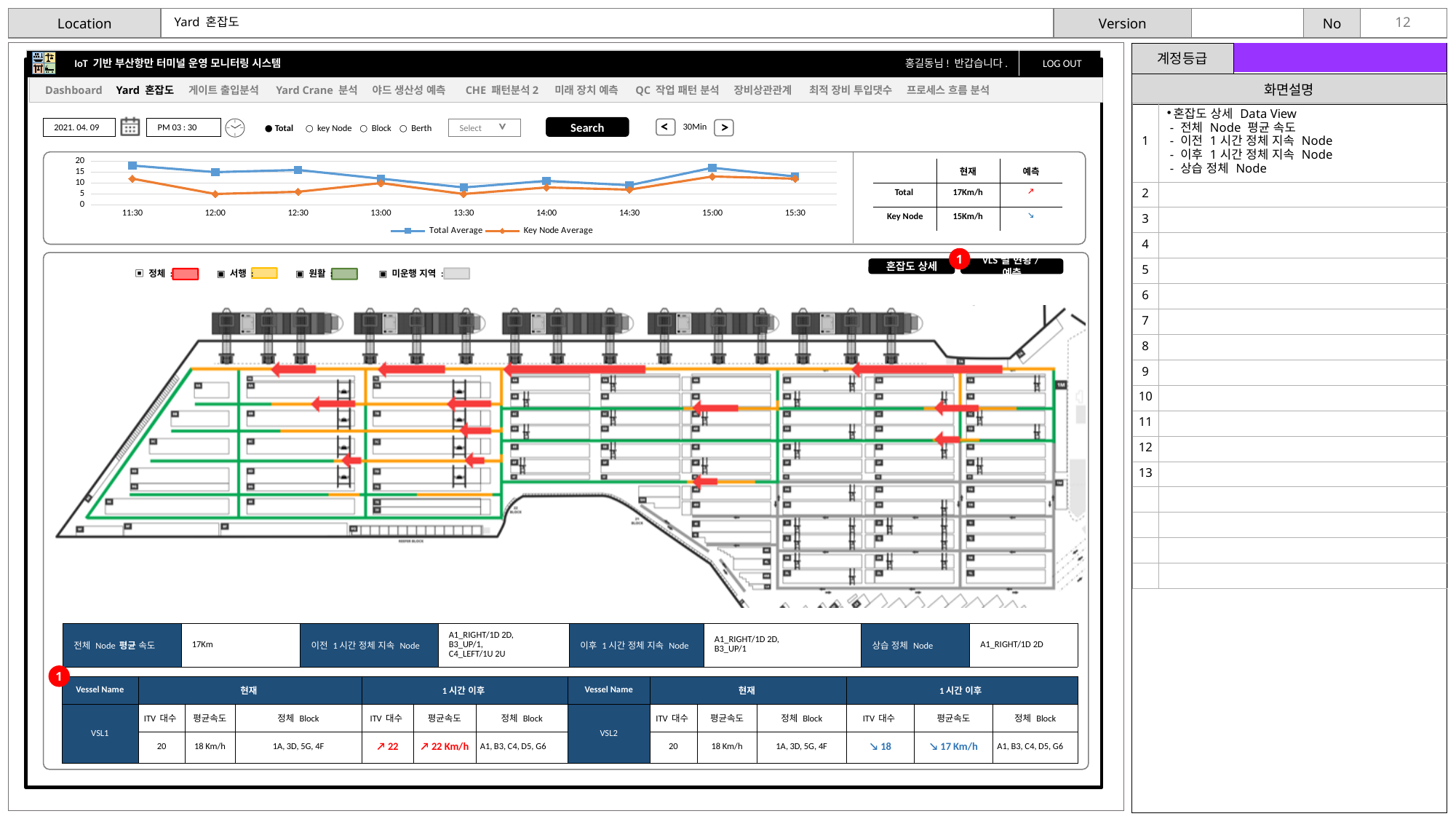
Is the Total Average value at 11:30 greater or less than 15? greater What kind of chart is shown at the top of the monitoring screen? line chart How many time points are plotted along the x axis of the line chart? 9 What are the two series named in the line chart's legend? Total Average and Key Node Average What is the first time label on the x axis of the line chart? 11:30 At 12:00, which series has the larger value, Total Average or Key Node Average? Total Average Is the Key Node Average value at 15:00 greater or less than 10? greater Is the Key Node Average value at 12:00 greater or less than 10? less Does the Key Node Average series rise or fall from 13:30 to 15:00? rise Does the Total Average series rise or fall from 11:30 to 13:30? fall How many series does the legend of the line chart list? 2